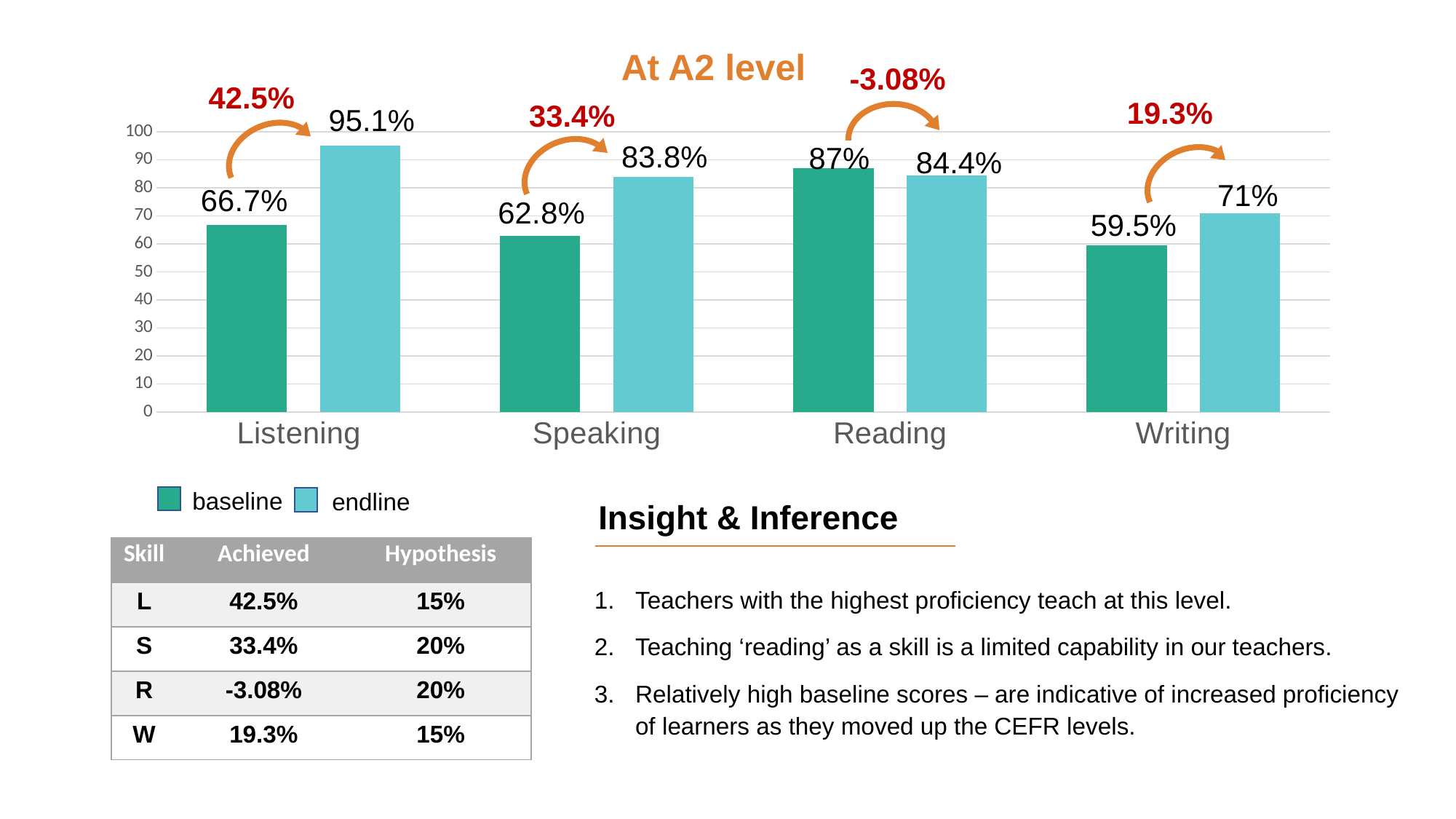
What are the two series named in the legend? baseline and endline For Reading, which is larger, the baseline or the endline value? baseline What is the difference between the endline and baseline values for Listening? 28.4% What kind of chart is shown on the slide? bar chart What is the endline value for Writing? 71% What is the baseline value for Reading? 87% Which skill has the highest endline value? Listening Which skill has the lowest baseline value? Writing How many series does the legend list? 2 How many skill categories are shown on the x axis? 4 What is the endline value for Speaking? 83.8% What is the baseline value for Listening? 66.7%